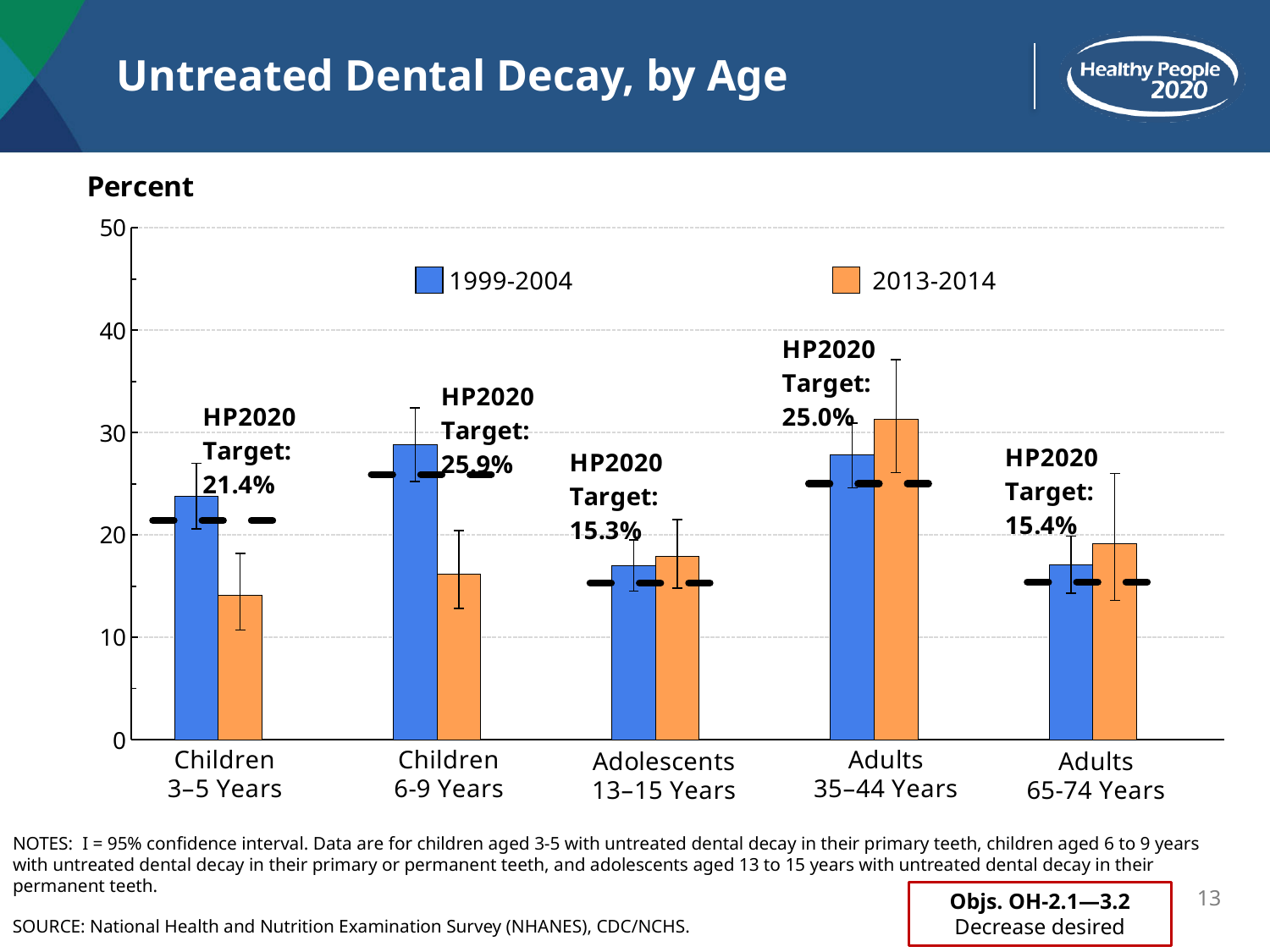
How many age groups are shown on the x axis? 5 For Adults 35–44 Years, which period has the larger value, 1999-2004 or 2013-2014? 2013-2014 For Children 3–5 Years, which period has the larger value, 1999-2004 or 2013-2014? 1999-2004 What is the title of the chart? Untreated Dental Decay, by Age How many series does the legend list? 2 Is the 2013-2014 value for Children 6-9 Years greater or less than 20? less What kind of chart is shown on the slide? bar chart What is the HP2020 target for Adolescents 13–15 Years? 15.3% What is the HP2020 target for Adults 35–44 Years? 25.0% What is the HP2020 target for Children 3–5 Years? 21.4% Which age group has the lowest HP2020 target? Adolescents 13–15 Years Which age group and period has the tallest bar in the chart? Adults 35–44 Years, 2013-2014